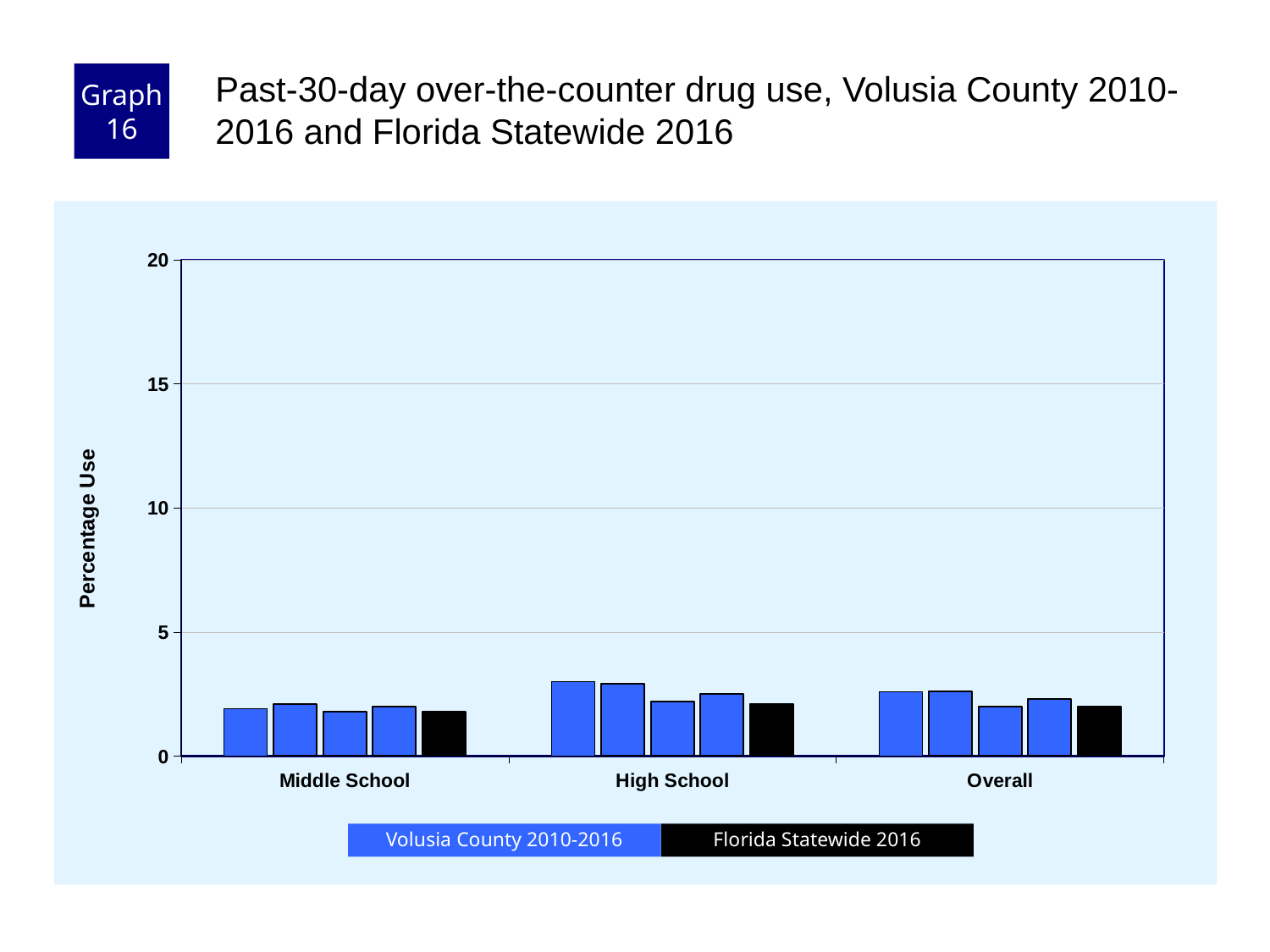
What is the label on the y axis? Percentage Use How many series does the legend list? 2 Which category has the tallest bars overall? High School Is the tallest Volusia County bar in High School larger or smaller than the tallest Volusia County bar in Middle School? larger Are any of the bars in the Middle School category greater or less than 5? less Is the value for Florida Statewide 2016 in the Overall category greater or less than 5? less What kind of chart is shown on the slide? bar chart What is the maximum value shown on the y axis? 20 Is the value for Florida Statewide 2016 in the High School category greater or less than 5? less How many categories are shown on the x axis? 3 What colour are the Florida Statewide 2016 bars? black